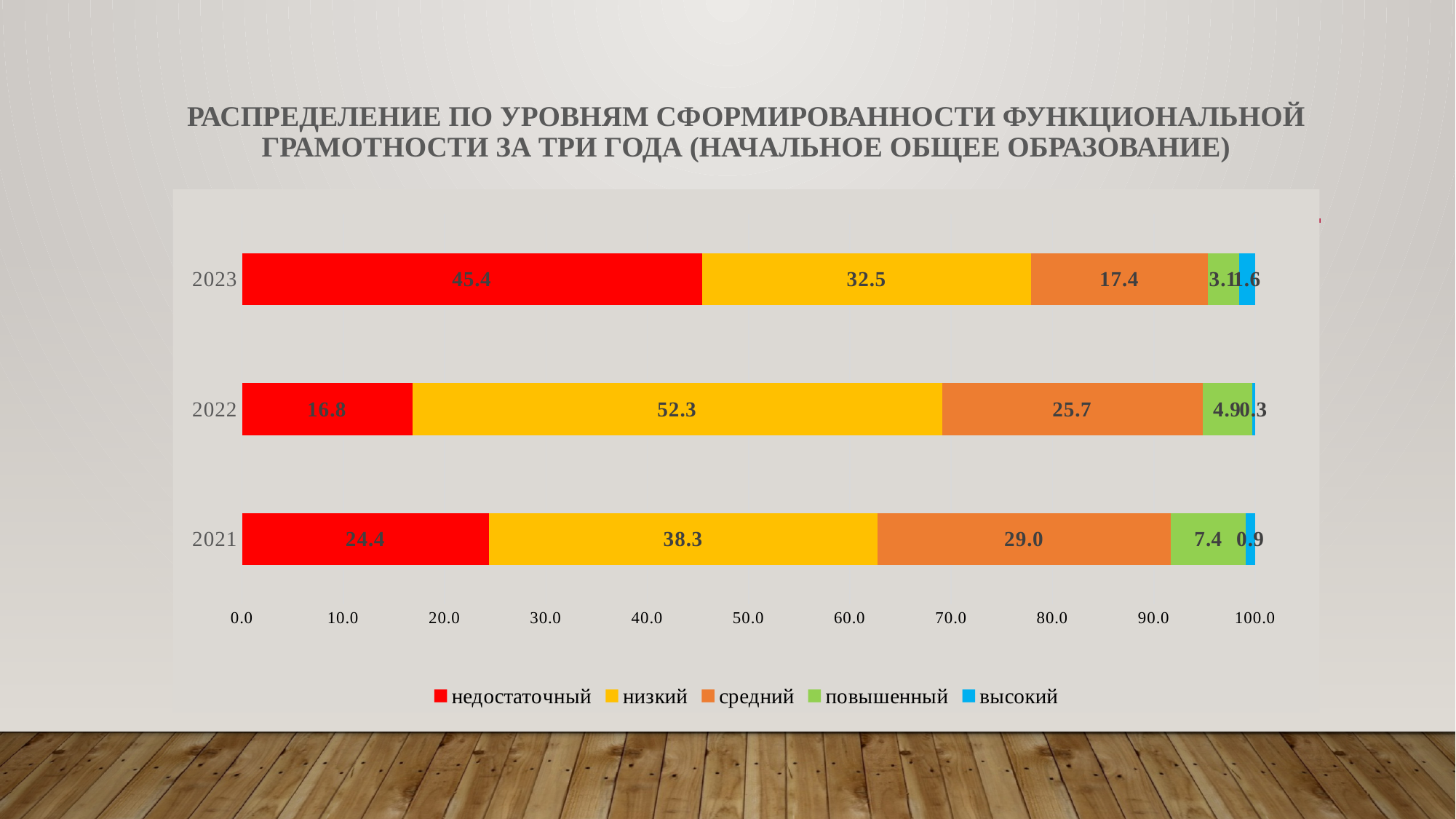
What is the value for средний in 2021? 29.0 How many series does the legend list? 5 Which year has the lowest value for недостаточный? 2022 Which year has the larger value for средний, 2021 or 2022? 2021 What is the value for низкий in 2022? 52.3 What is the value for повышенный in 2021? 7.4 What is the difference between the низкий values for 2022 and 2023? 19.8 How many years are shown on the chart? 3 What is the value for высокий in 2021? 0.9 What is the value for недостаточный in 2023? 45.4 What kind of chart is shown on the slide? Stacked bar chart Which year has the highest value for недостаточный? 2023